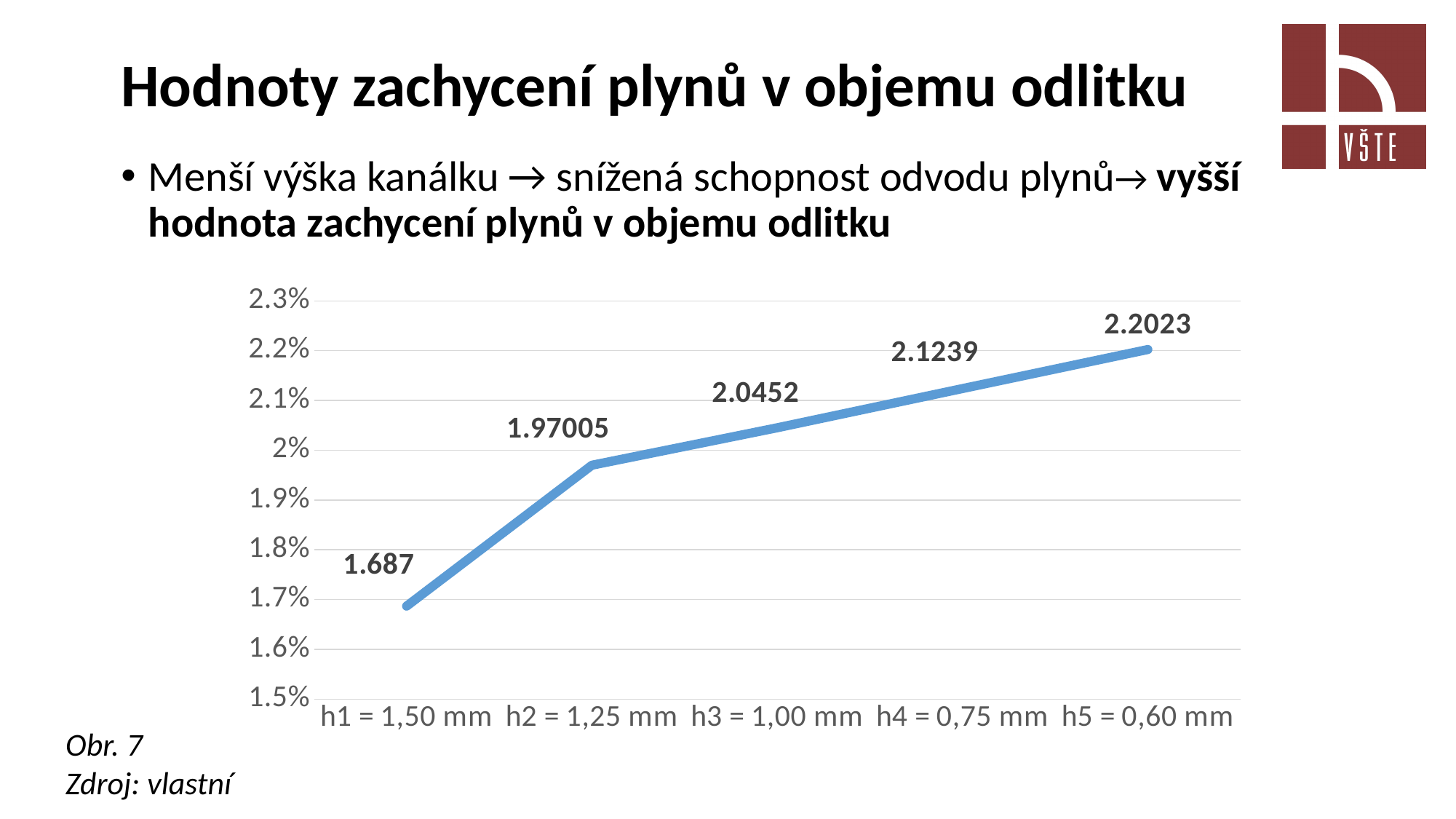
Which category has the highest value? h5 = 0,60 mm What is the value for h3 = 1,00 mm? 2.0452 How many data points are plotted on the chart? 5 What is the difference between the values for h5 = 0,60 mm and h1 = 1,50 mm? 0.5153 Which category has the lowest value? h1 = 1,50 mm Is the value for h1 = 1,50 mm greater or less than 1.8%? less What is the value for h2 = 1,25 mm? 1.97005 Which is larger, the value for h2 = 1,25 mm or the value for h4 = 0,75 mm? h4 = 0,75 mm What is the value for h5 = 0,60 mm? 2.2023 What is the difference between the values for h4 = 0,75 mm and h3 = 1,00 mm? 0.0787 What is the value for h1 = 1,50 mm? 1.687 What kind of chart is shown on the slide? line chart